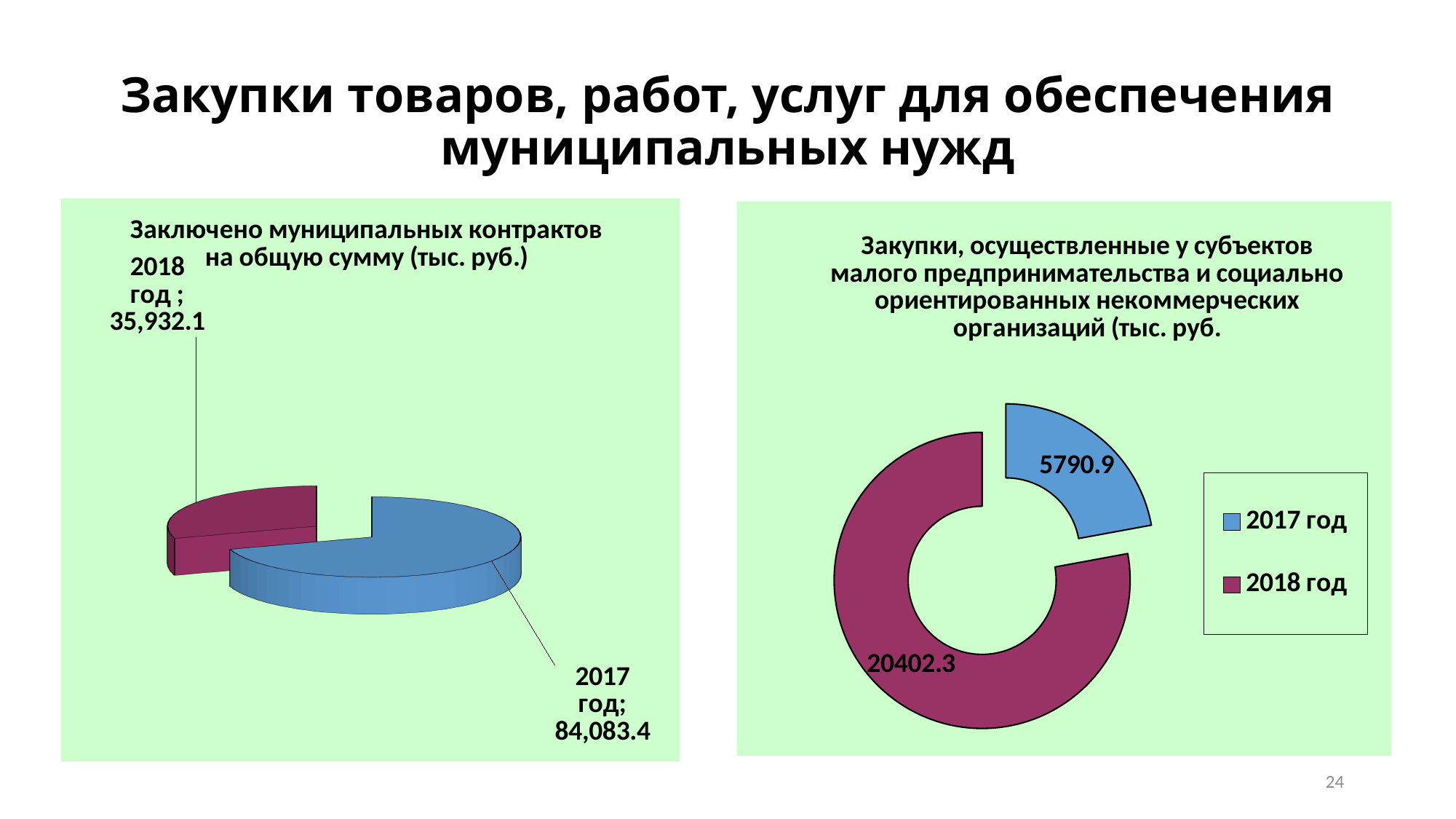
In the right chart (Закупки, осуществленные у субъектов малого предпринимательства), what is the value for 2018 год? 20402.3 In the left chart (Заключено муниципальных контрактов), what is the value for 2018 год? 35,932.1 How many entries does the legend of the right chart (Закупки, осуществленные у субъектов малого предпринимательства) list? 2 What kind of chart is the left chart (Заключено муниципальных контрактов)? pie chart In the left chart (Заключено муниципальных контрактов), what is the value for 2017 год? 84,083.4 In the left chart (Заключено муниципальных контрактов), which year has the larger value? 2017 год How many slices does the left chart (Заключено муниципальных контрактов) have? 2 In the right chart (Закупки, осуществленные у субъектов малого предпринимательства), which year has the smaller value? 2017 год In the left chart (Заключено муниципальных контрактов), what is the difference between the 2017 год and 2018 год values? 48,151.3 In the right chart (Закупки, осуществленные у субъектов малого предпринимательства), is the value for 2018 год larger or smaller than the value for 2017 год? larger In the right chart (Закупки, осуществленные у субъектов малого предпринимательства), what is the value for 2017 год? 5790.9 In the right chart (Закупки, осуществленные у субъектов малого предпринимательства), what is the difference between the 2018 год and 2017 год values? 14611.4